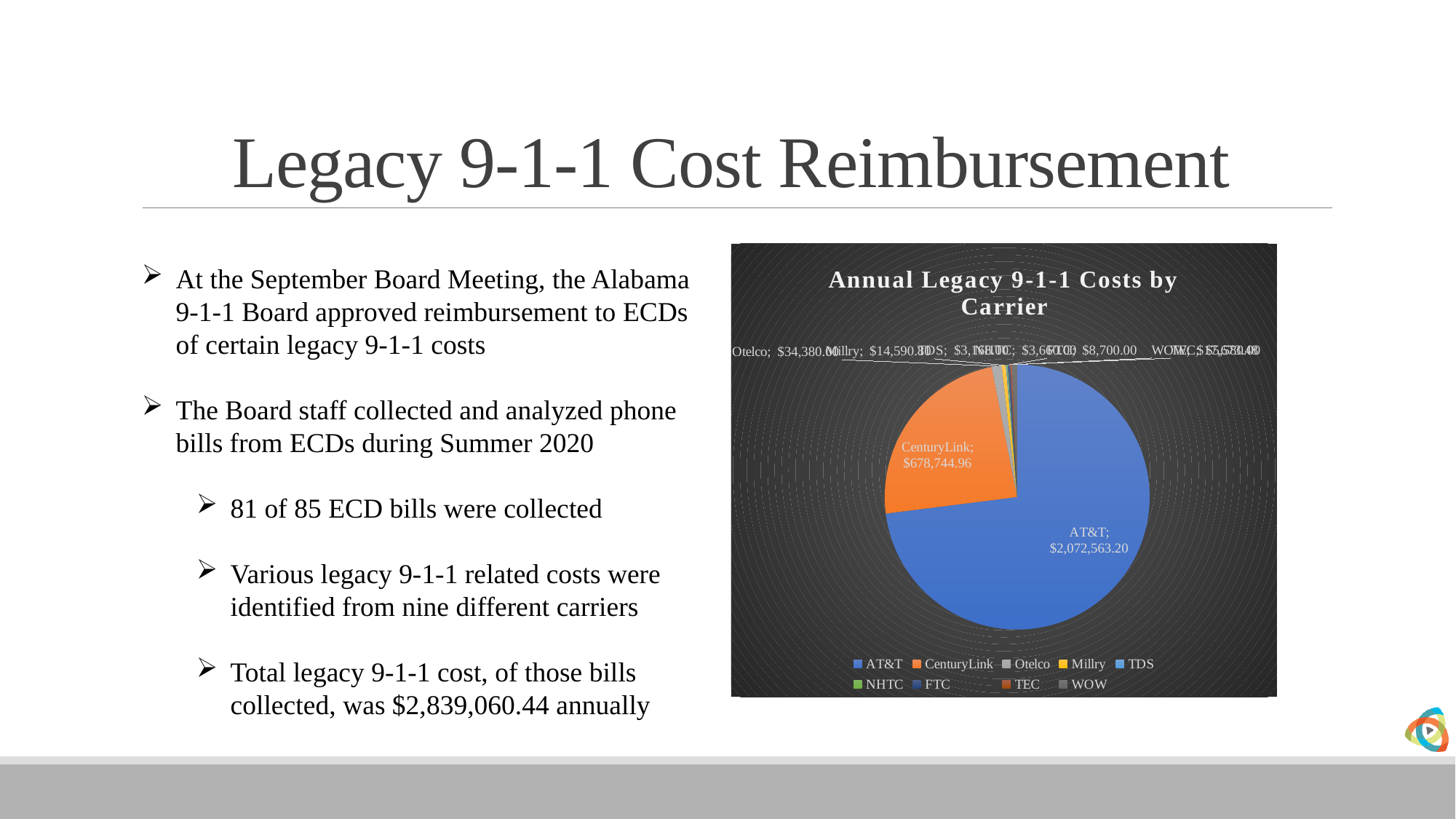
Which carrier has the larger cost, AT&T or CenturyLink? AT&T What is the annual legacy 9-1-1 cost for Otelco? $34,380.00 What is the annual legacy 9-1-1 cost for CenturyLink? $678,744.96 What is the annual legacy 9-1-1 cost for Millry? $14,590.80 Which carrier has the largest slice of the pie? AT&T What is the annual legacy 9-1-1 cost for FTC? $8,700.00 What is the difference between the AT&T cost and the CenturyLink cost? $1,393,818.24 Which colour represents CenturyLink in the pie chart? orange How many carriers are listed in the chart legend? 9 What kind of chart is shown on the slide? pie chart What is the title of the chart? Annual Legacy 9-1-1 Costs by Carrier What is the annual legacy 9-1-1 cost for AT&T? $2,072,563.20